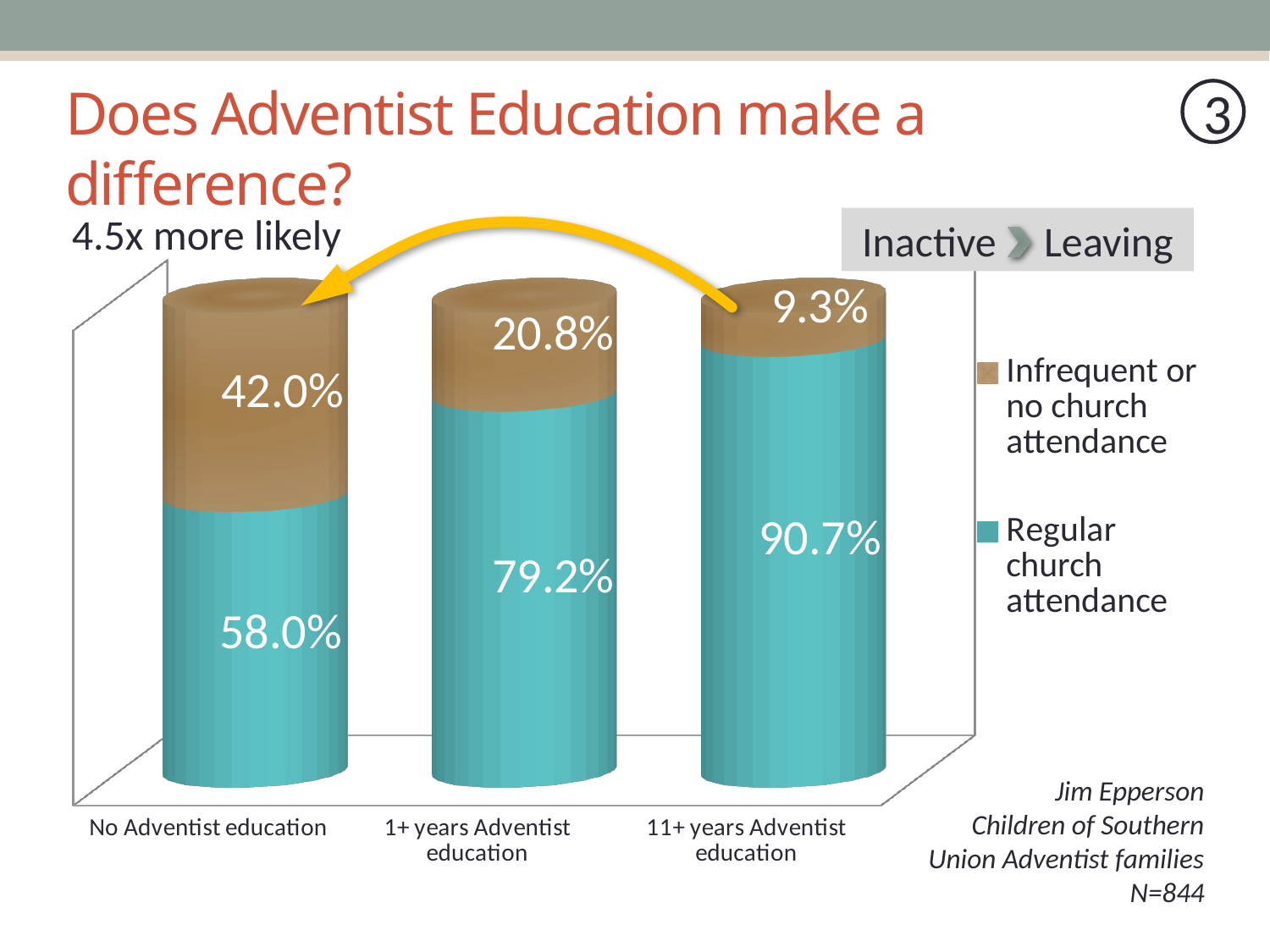
Which category has the highest value for Infrequent or no church attendance? No Adventist education What is the value for Regular church attendance in the 11+ years Adventist education category? 90.7% What kind of chart is shown on the slide? Stacked bar chart Does the Regular church attendance value rise or fall from No Adventist education to 11+ years Adventist education? Rise Which category has the lowest value for Regular church attendance? No Adventist education What is the difference between the Regular church attendance values for 11+ years Adventist education and No Adventist education? 32.7% What is the value for Infrequent or no church attendance in the 1+ years Adventist education category? 20.8% Which is larger: Infrequent or no church attendance for No Adventist education or for 1+ years Adventist education? No Adventist education How many categories are shown on the x axis? 3 What is the value for Infrequent or no church attendance in the 11+ years Adventist education category? 9.3% What is the value for Regular church attendance in the No Adventist education category? 58.0% How many series does the legend list? 2